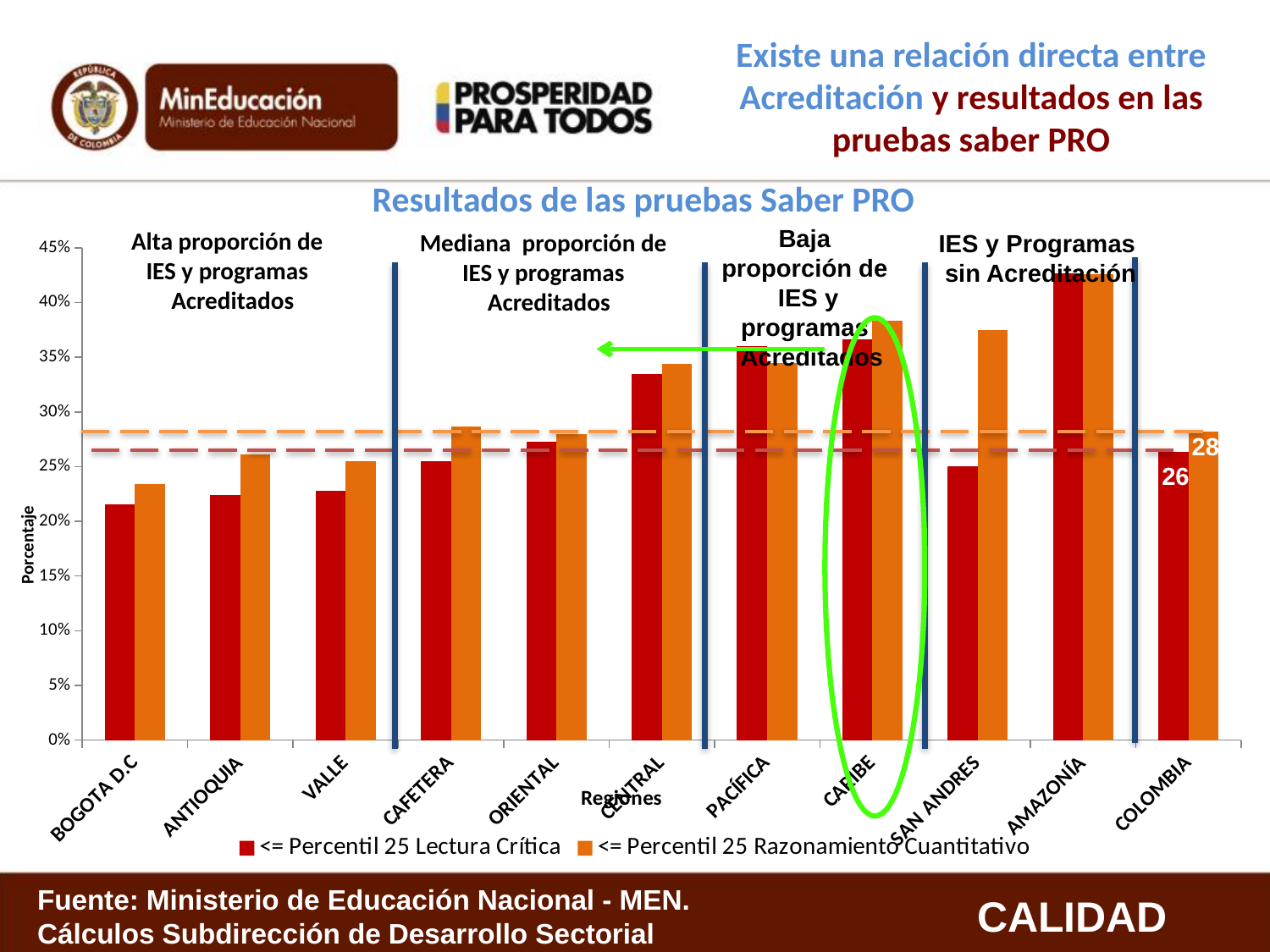
Which region has the larger '<= Percentil 25 Lectura Crítica' value, CENTRAL or BOGOTA D.C? CENTRAL What is the labelled value for COLOMBIA in the '<= Percentil 25 Lectura Crítica' series? 26 Which region has the highest value for '<= Percentil 25 Razonamiento Cuantitativo'? AMAZONÍA Is the '<= Percentil 25 Razonamiento Cuantitativo' value for SAN ANDRES greater or less than 35%? greater How many regions (categories) are shown on the x axis? 11 What kind of chart is shown on the slide? Bar chart Is the '<= Percentil 25 Lectura Crítica' value for BOGOTA D.C greater or less than 25%? less Which region has the lowest value for '<= Percentil 25 Razonamiento Cuantitativo'? BOGOTA D.C What is the title of the chart? Resultados de las pruebas Saber PRO For SAN ANDRES, which series has the larger value: '<= Percentil 25 Lectura Crítica' or '<= Percentil 25 Razonamiento Cuantitativo'? <= Percentil 25 Razonamiento Cuantitativo What is the labelled value for COLOMBIA in the '<= Percentil 25 Razonamiento Cuantitativo' series? 28 How many series does the legend list? 2